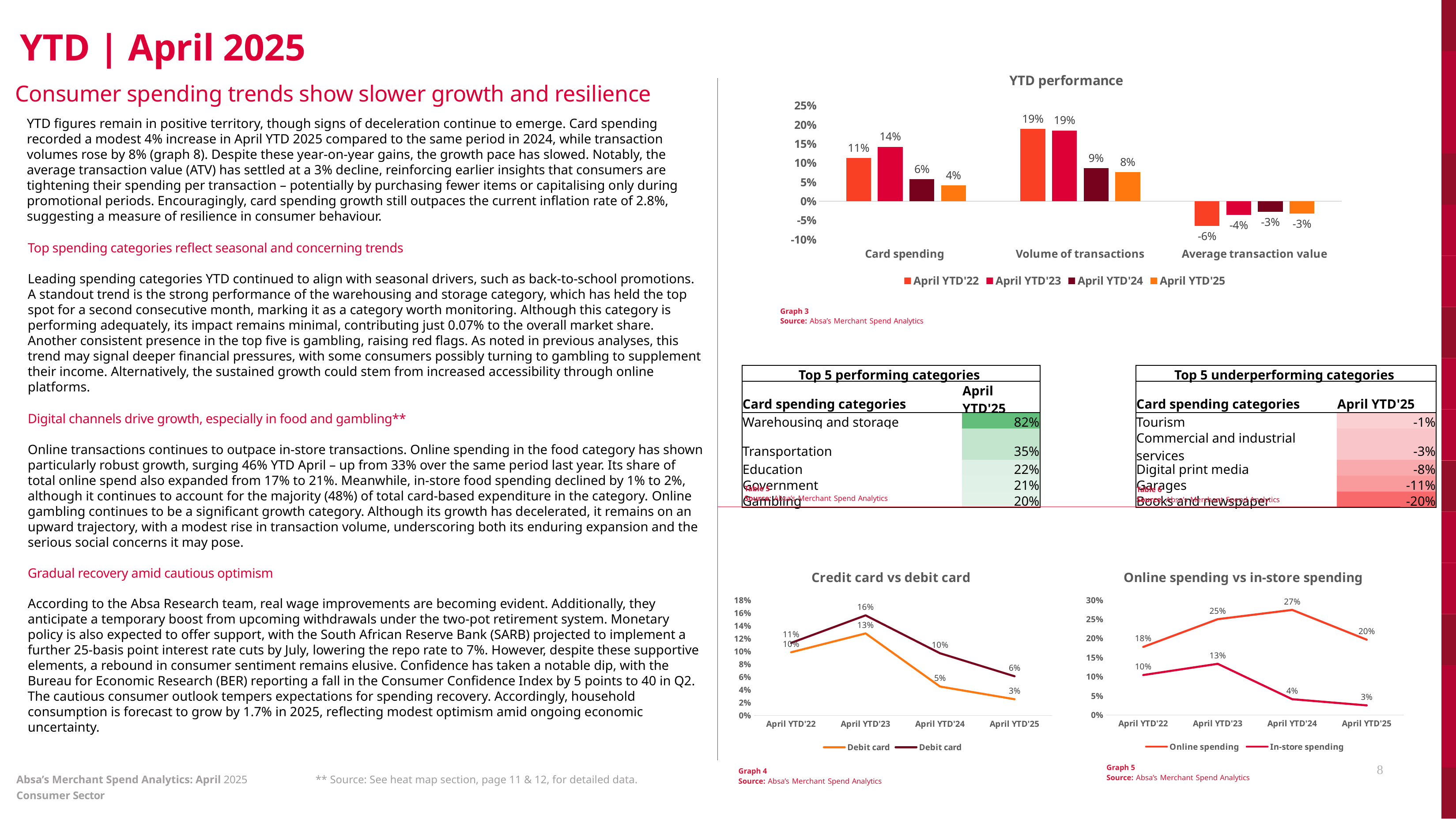
In the Online spending vs in-store spending chart, what is the value for In-store spending in April YTD'25? 3% What kind of chart is the Credit card vs debit card chart? Line chart In the Online spending vs in-store spending chart, what is the difference between Online spending and In-store spending in April YTD'23? 12 percentage points In the Online spending vs in-store spending chart, what is the value for Online spending in April YTD'24? 27% How many series does the legend of the YTD performance chart list? 4 In the YTD performance chart, what is the difference between Card spending in April YTD'23 and April YTD'25? 10 percentage points In the YTD performance chart, what is the value for Volume of transactions in April YTD'22? 19% What kind of chart is the YTD performance chart? Bar chart In the YTD performance chart, what is the value for Card spending in April YTD'25? 4% In the YTD performance chart, which is larger: Card spending in April YTD'22 or Card spending in April YTD'24? April YTD'22 In the Online spending vs in-store spending chart, in which period is Online spending highest? April YTD'24 In the YTD performance chart, what is the value for Average transaction value in April YTD'22? -6%